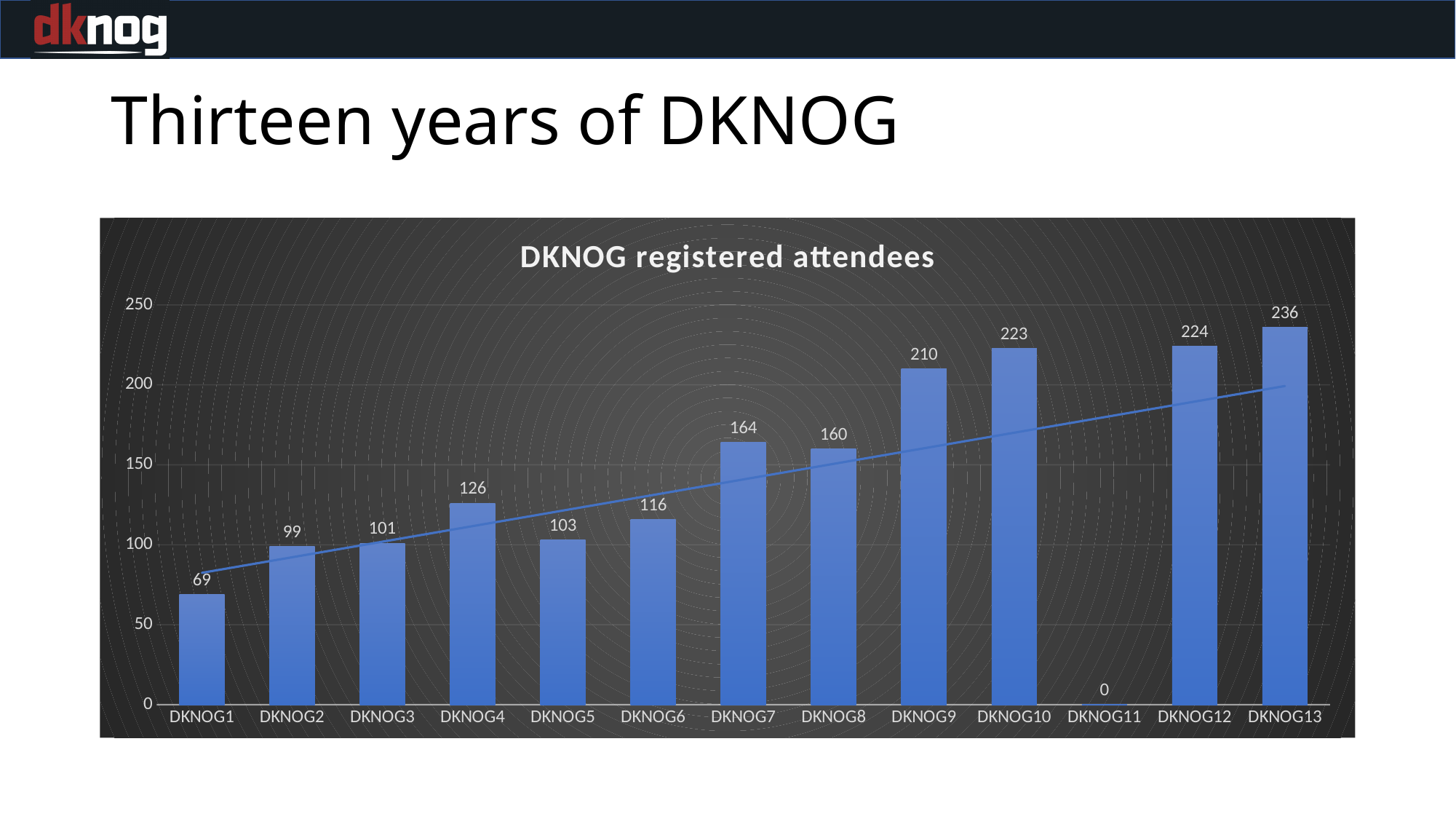
What kind of chart is shown on the slide? bar chart What is the value for DKNOG11? 0 How many DKNOG events are shown on the x axis of the chart? 13 Is the value for DKNOG8 greater or less than 150? greater Which DKNOG event has the highest number of registered attendees? DKNOG13 What is the value for DKNOG7 in the DKNOG registered attendees chart? 164 What is the difference between the values for DKNOG10 and DKNOG9? 13 Which DKNOG event has the lowest number of registered attendees? DKNOG11 What is the title of the chart? DKNOG registered attendees What is the difference in registered attendees between DKNOG13 and DKNOG1? 167 Which has more registered attendees, DKNOG4 or DKNOG6? DKNOG4 How many registered attendees are shown for DKNOG1? 69